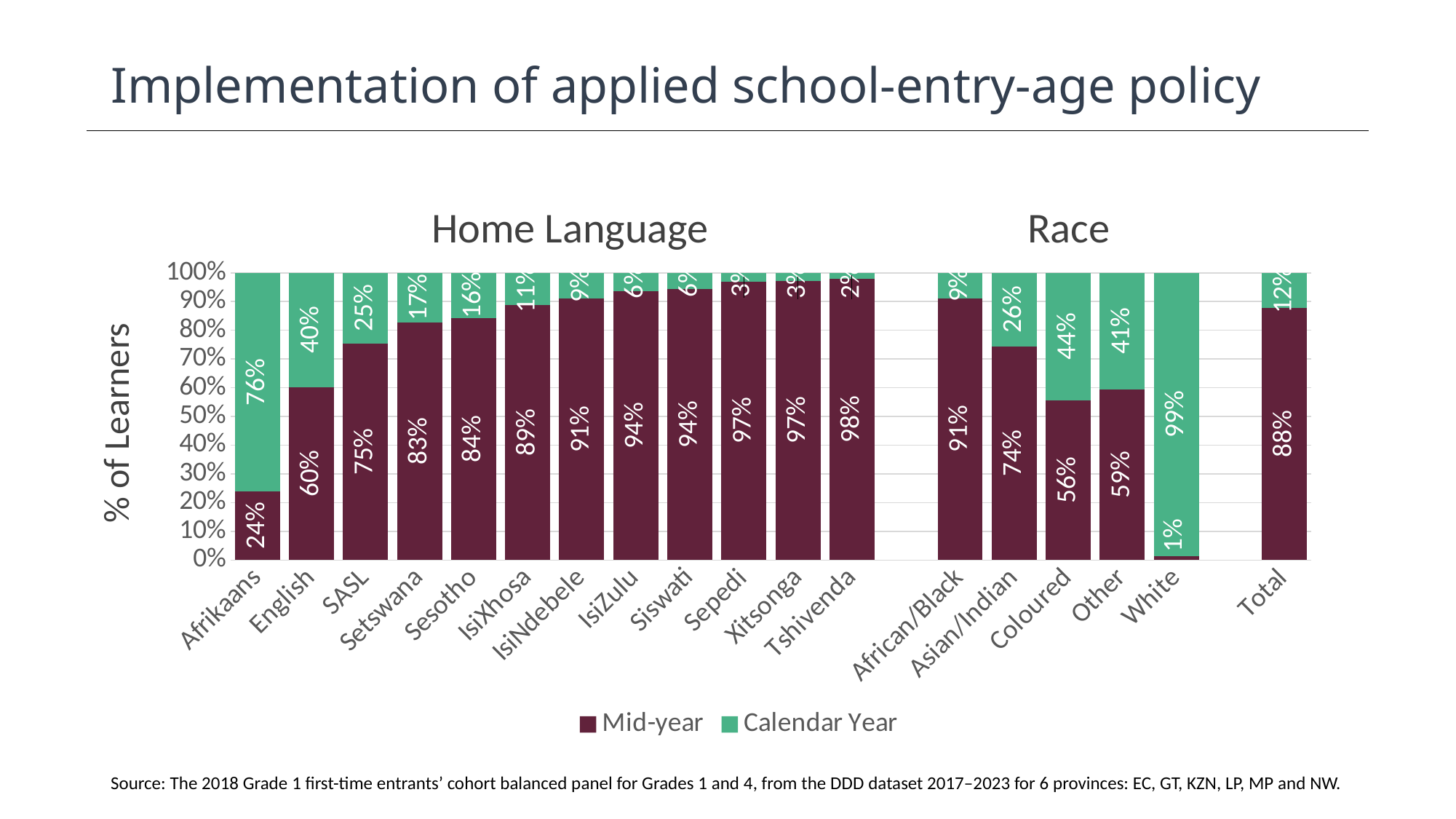
Which has a larger Mid-year value, Asian/Indian or Coloured? Asian/Indian What is the Calendar Year value for White? 99% How many categories are shown on the x axis in total? 18 What is the Mid-year value for Afrikaans? 24% Which home language category has the highest Mid-year value? Tshivenda How many series does the legend list? 2 What is the label on the vertical axis? % of Learners What is the Calendar Year value for Coloured? 44% What is the difference between the Mid-year values for English and Afrikaans? 36% What is the Mid-year value for Total? 88% Which race category has the lowest Mid-year value? White What kind of chart is shown on the slide? Stacked bar chart